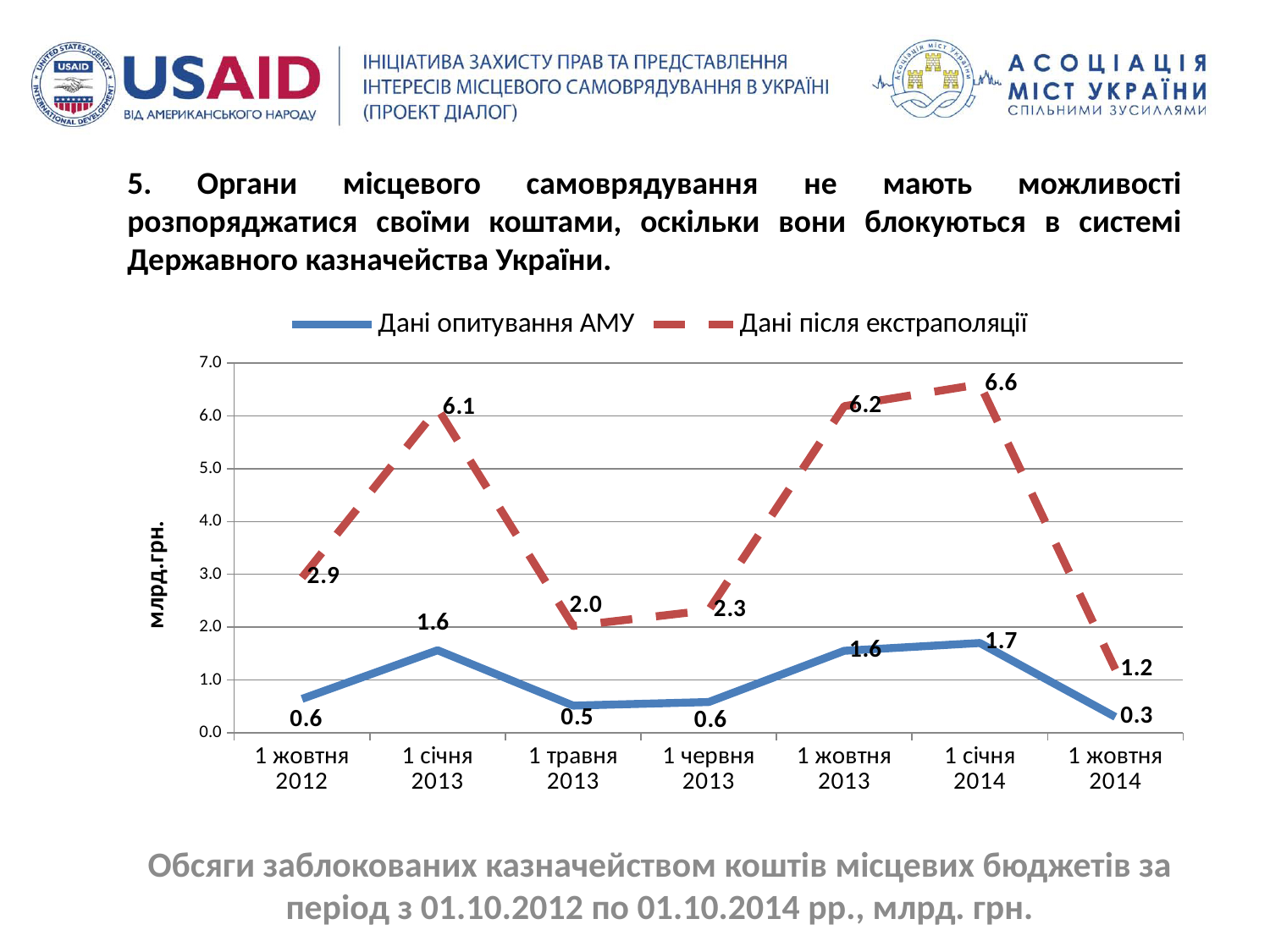
What unit is shown on the y axis of the chart? млрд.грн. What is the value of the 'Дані опитування АМУ' series on 1 травня 2013? 0.5 How many dates are plotted along the x axis of the chart? 7 What type of chart is shown on the slide? line chart What is the difference between the 'Дані після екстраполяції' and 'Дані опитування АМУ' values on 1 січня 2013? 4.5 On which date does the 'Дані після екстраполяції' series reach its highest value? 1 січня 2014 Does the 'Дані опитування АМУ' series rise or fall between 1 січня 2014 and 1 жовтня 2014? fall What is the value of the 'Дані після екстраполяції' series on 1 січня 2014? 6.6 On which date does the 'Дані опитування АМУ' series have its lowest value? 1 жовтня 2014 Which is larger for the 'Дані після екстраполяції' series: the value on 1 жовтня 2013 or on 1 жовтня 2014? 1 жовтня 2013 How many series does the chart legend list? 2 What is the value of the 'Дані після екстраполяції' series on 1 жовтня 2012? 2.9